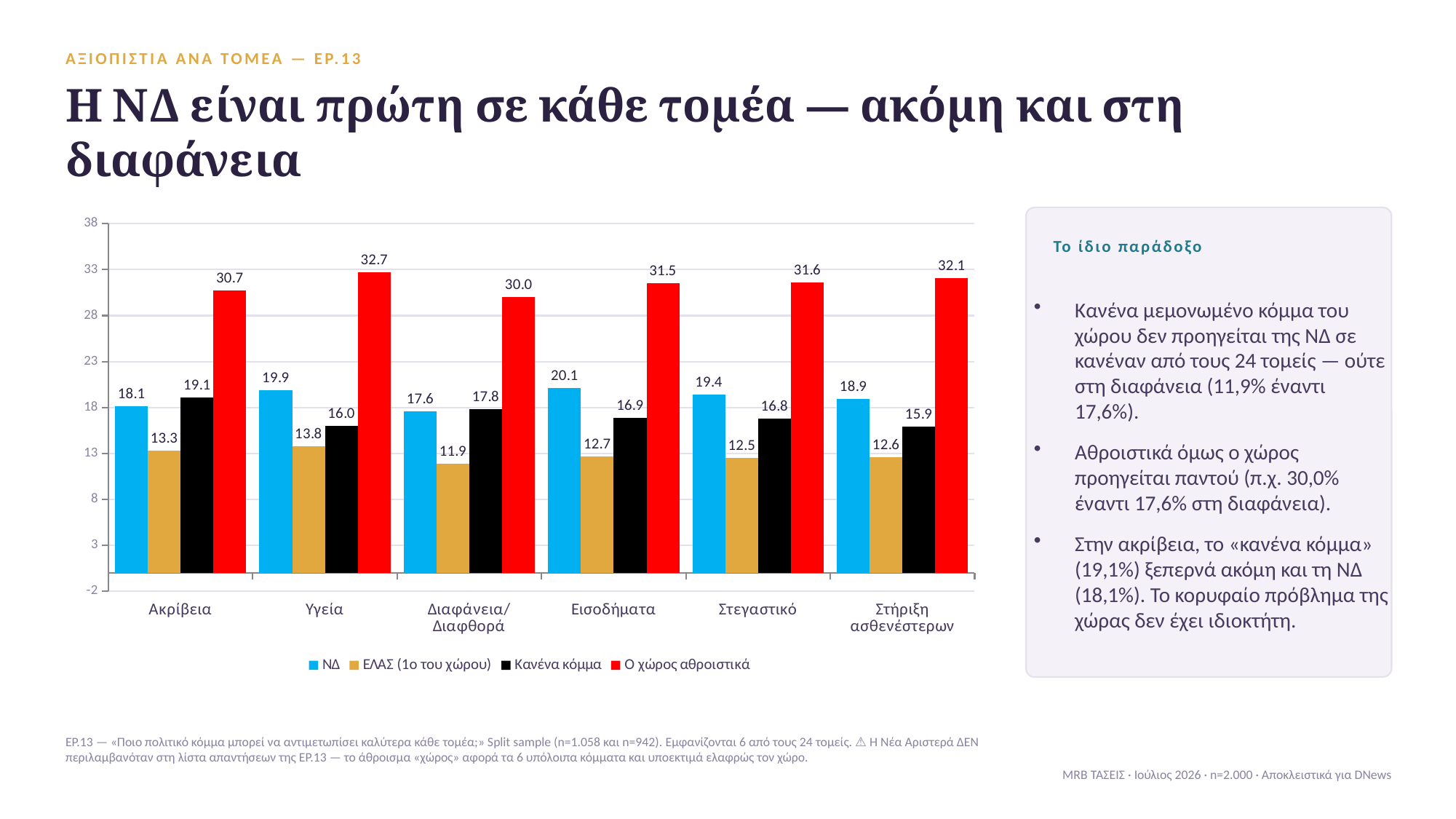
Which colour represents Ο χώρος αθροιστικά in the chart? red In which category does Ο χώρος αθροιστικά reach its highest value? Υγεία What is the value for ΝΔ in the Υγεία category? 19.9 What is the difference between Ο χώρος αθροιστικά and ΝΔ in the Ακρίβεια category? 12.6 In the Ακρίβεια category, which is larger: ΝΔ or Κανένα κόμμα? Κανένα κόμμα In which category does ΕΛΑΣ (1ο του χώρου) have its lowest value? Διαφάνεια/Διαφθορά What is the value for Ο χώρος αθροιστικά in the Διαφάνεια/Διαφθορά category? 30.0 What is the value for ΕΛΑΣ (1ο του χώρου) in the Στεγαστικό category? 12.5 Is the value for Κανένα κόμμα in the Εισοδήματα category greater or less than 18? less How many series does the legend list? 4 What kind of chart is shown on the slide? bar chart How many categories are shown on the x axis? 6